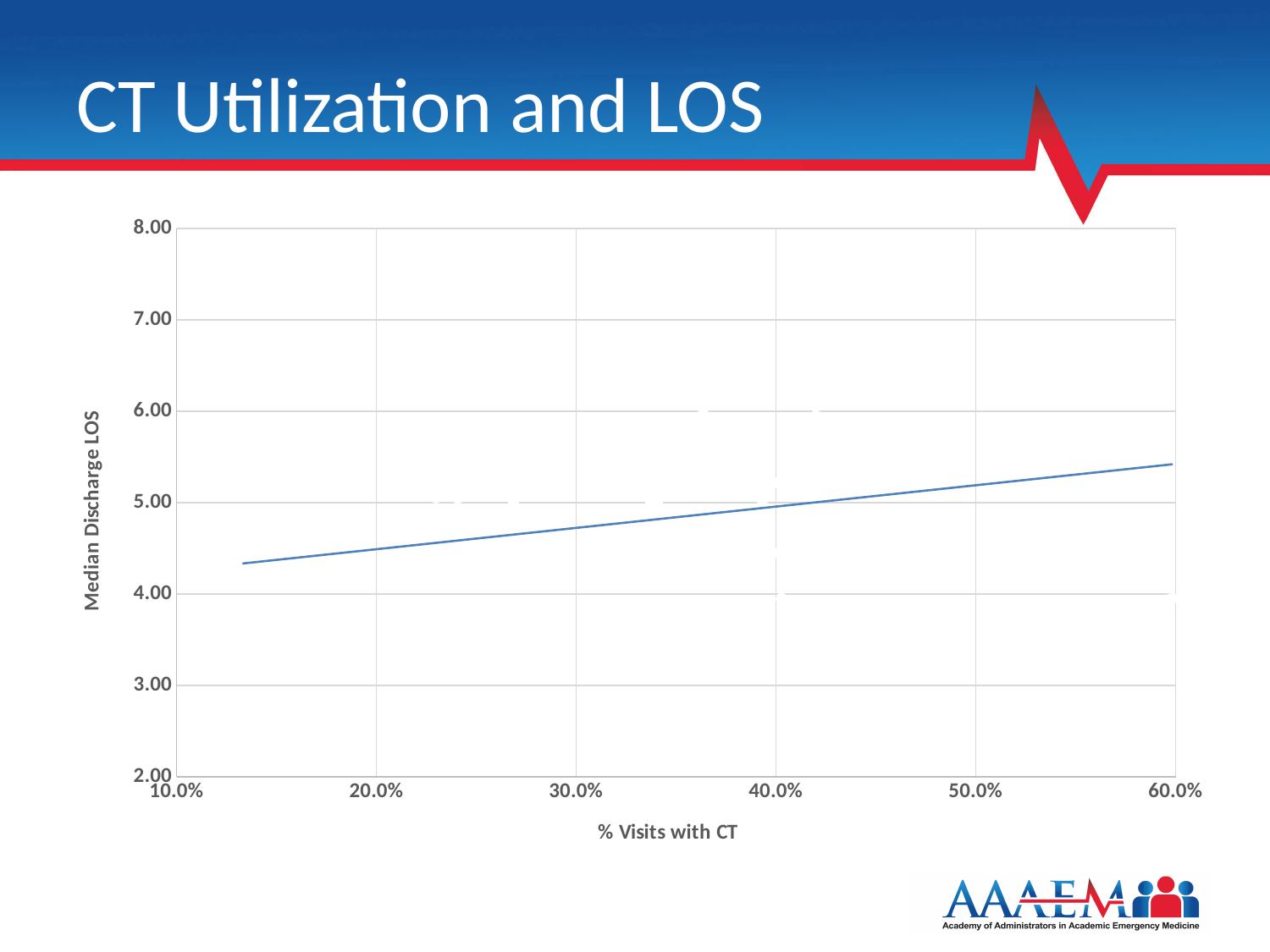
Does the Median Discharge LOS rise or fall as % Visits with CT increases? rise Is the Median Discharge LOS at 50.0% visits with CT greater or less than 5.00? greater Is the Median Discharge LOS at 20.0% visits with CT greater or less than 5.00? less Is the Median Discharge LOS at 30.0% visits with CT greater or less than 5.00? less What is the label of the vertical axis? Median Discharge LOS Which is higher, the Median Discharge LOS at 20.0% or at 50.0% visits with CT? 50.0% What kind of chart is shown on the slide? line chart What is the title of the slide containing the chart? CT Utilization and LOS